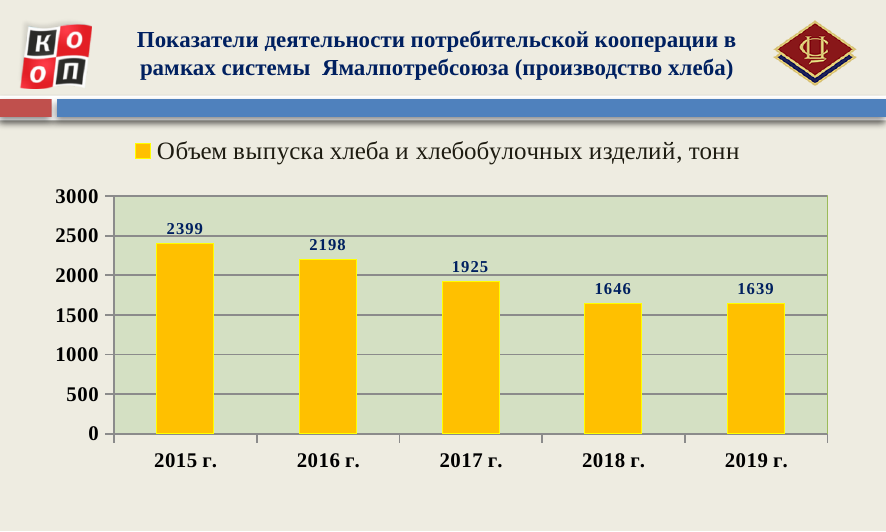
What is the value for 2019 г.? 1639 What is the difference between the values for 2015 г. and 2016 г.? 201 How many years are shown on the x axis? 5 What is the value for 2015 г.? 2399 Which year has the highest value? 2015 г. What is the value for 2017 г.? 1925 Which year has the lowest value? 2019 г. Is the value for 2017 г. greater or less than 2000? less Do the values rise or fall from 2015 г. to 2019 г.? fall Which is larger, the value for 2016 г. or the value for 2018 г.? 2016 г. What is the difference between the values for 2017 г. and 2018 г.? 279 What kind of chart is this? bar chart